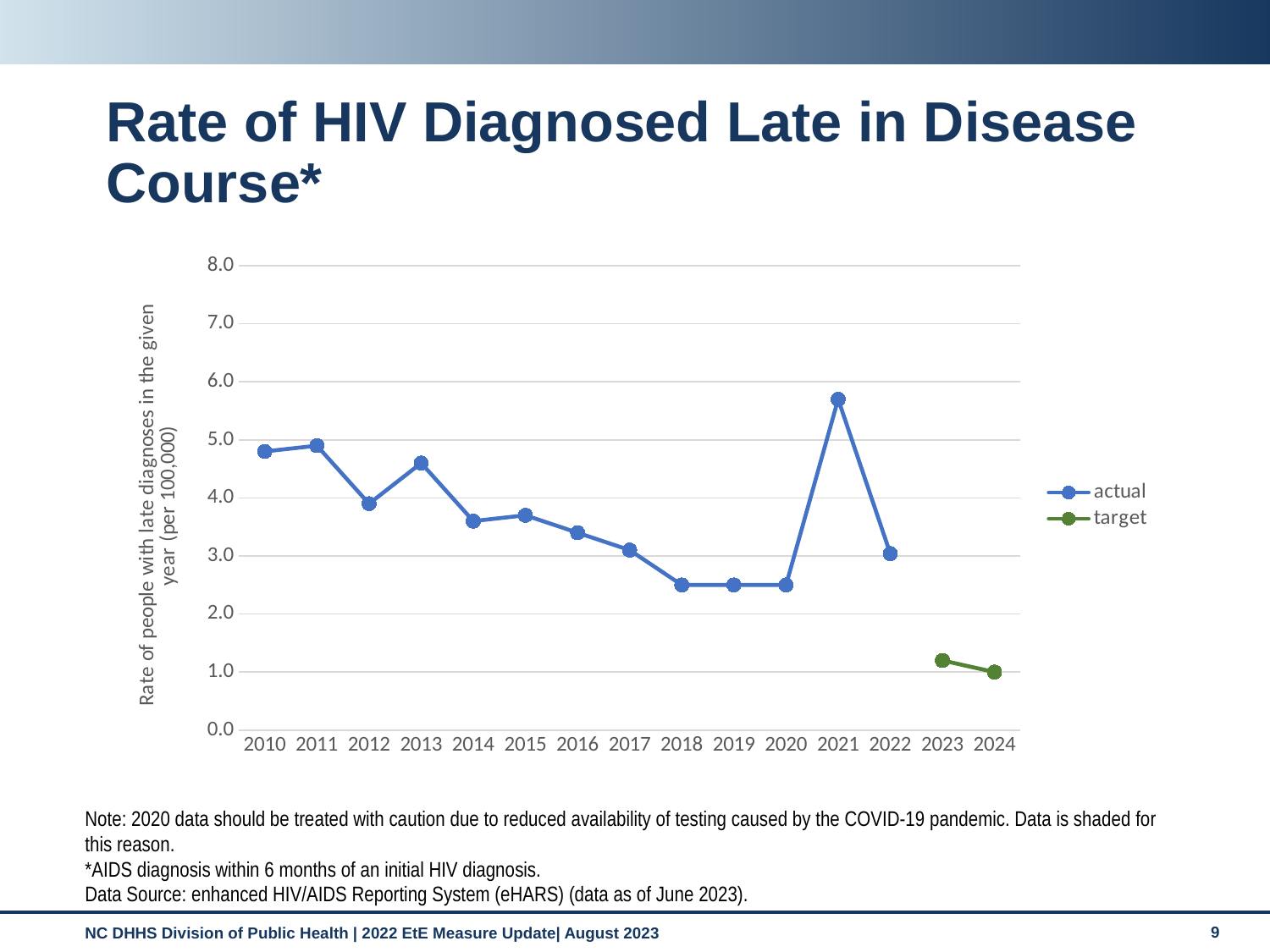
What are the two series named in the legend? actual and target Is the actual value for 2018 greater or less than 2.0? greater How many years are shown on the x axis? 15 Does the actual rate generally rise or fall from 2010 to 2018? fall Is the actual value for 2021 greater or less than 5.0? greater Which is larger, the actual value for 2010 or for 2012? 2010 How many data points does the target series have? 2 Is the actual value for 2012 greater or less than 4.0? less What kind of chart is shown on the slide? line chart How many series does the legend list? 2 Which is larger, the actual value for 2021 or for 2022? 2021 In which year is the actual rate highest? 2021